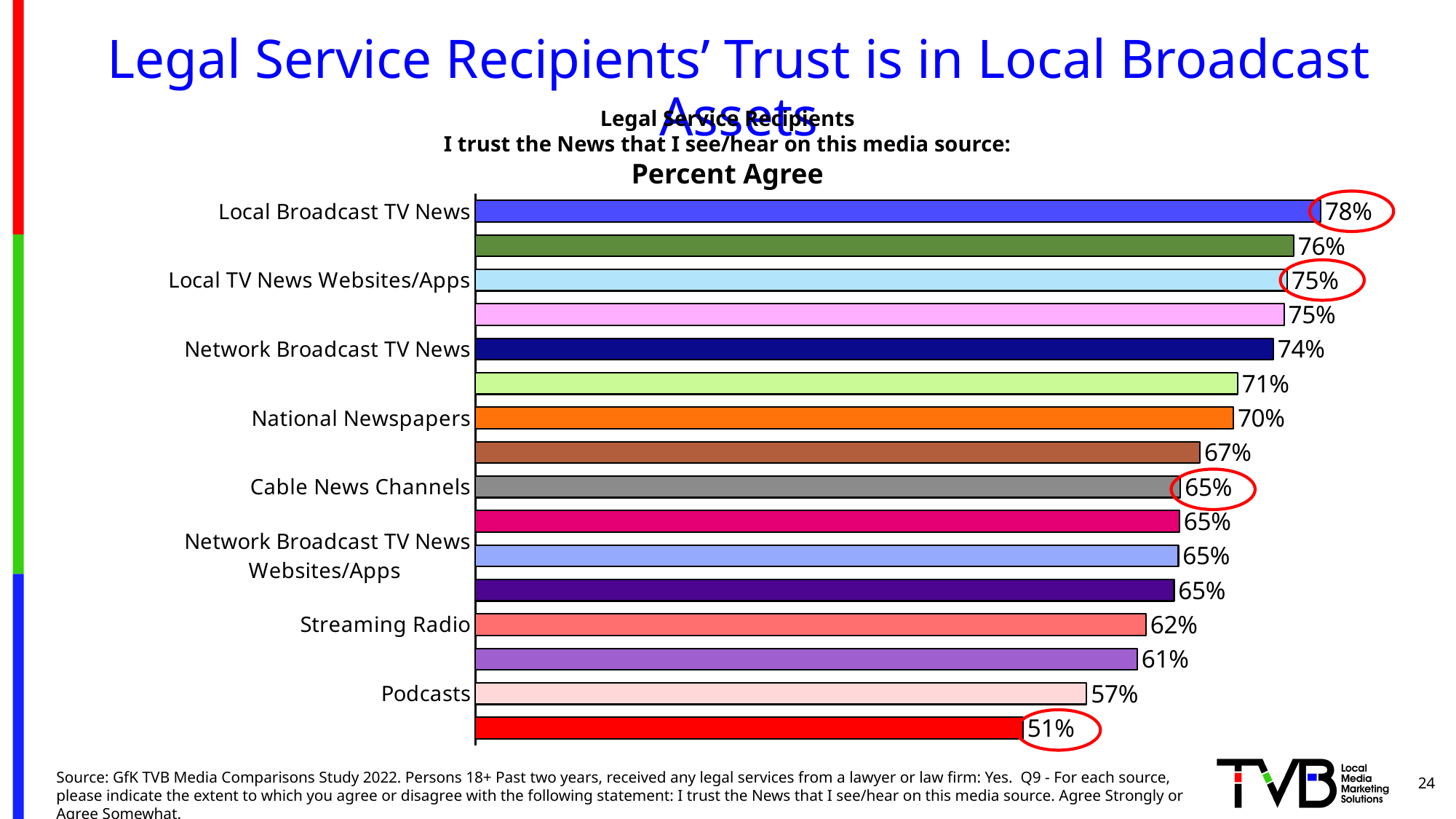
Which media source has the highest Percent Agree in the chart? Local Broadcast TV News What is the Percent Agree value for Network Broadcast TV News? 74% What is the lowest Percent Agree value shown on the chart? 51% What is the Percent Agree value for Cable News Channels? 65% Which has a higher Percent Agree: Network Broadcast TV News or National Newspapers? Network Broadcast TV News What percent of legal service recipients agree they trust the news on Local Broadcast TV News? 78% What is the Percent Agree value for Streaming Radio? 62% What is the Percent Agree value for National Newspapers? 70% What type of chart is shown on the slide? Bar chart What is the Percent Agree value for Local TV News Websites/Apps? 75% What is the Percent Agree value for Podcasts? 57% How many percentage points higher is Local Broadcast TV News than Local TV News Websites/Apps? 3 percentage points